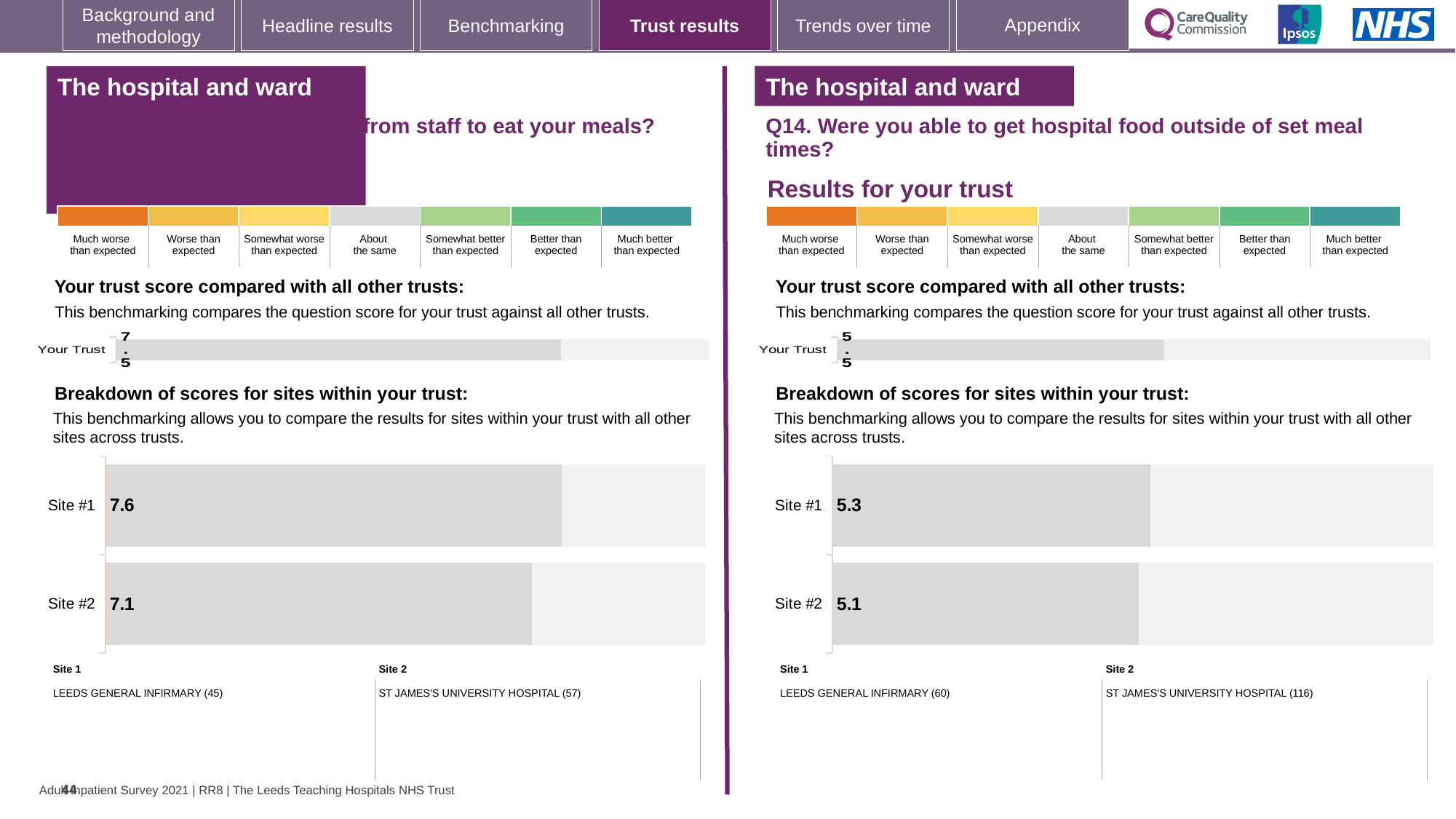
On the right-hand (Q14) side, what is the difference between the Site #1 and Site #2 scores in the site breakdown chart? 0.2 On the right-hand (Q14) side, what is the 'Your Trust' score in the chart comparing your trust with all other trusts? 5.5 On the left-hand side of the slide, what is the score shown for Site #1 in the breakdown of scores for sites within your trust? 7.6 On the right-hand (Q14) side, what is the score shown for Site #2 in the breakdown of scores for sites within your trust? 5.1 On the left-hand side of the slide, which site has the higher score in the breakdown of scores for sites within your trust? Site #1 On the left-hand side of the slide, what is the difference between the Site #1 and Site #2 scores in the site breakdown chart? 0.5 What kind of chart is used for the breakdown of scores for sites within your trust on the left-hand side of the slide? Bar chart On the right-hand (Q14) side, which site has the lower score in the breakdown of scores for sites within your trust? Site #2 On the left-hand side of the slide, what is the score shown for Site #2 in the breakdown of scores for sites within your trust? 7.1 On the right-hand (Q14) side, what is the score shown for Site #1 in the breakdown of scores for sites within your trust? 5.3 How many sites are shown in the breakdown of scores chart on the right-hand (Q14) side of the slide? 2 On the left-hand side of the slide, what is the 'Your Trust' score in the chart comparing your trust with all other trusts? 7.5